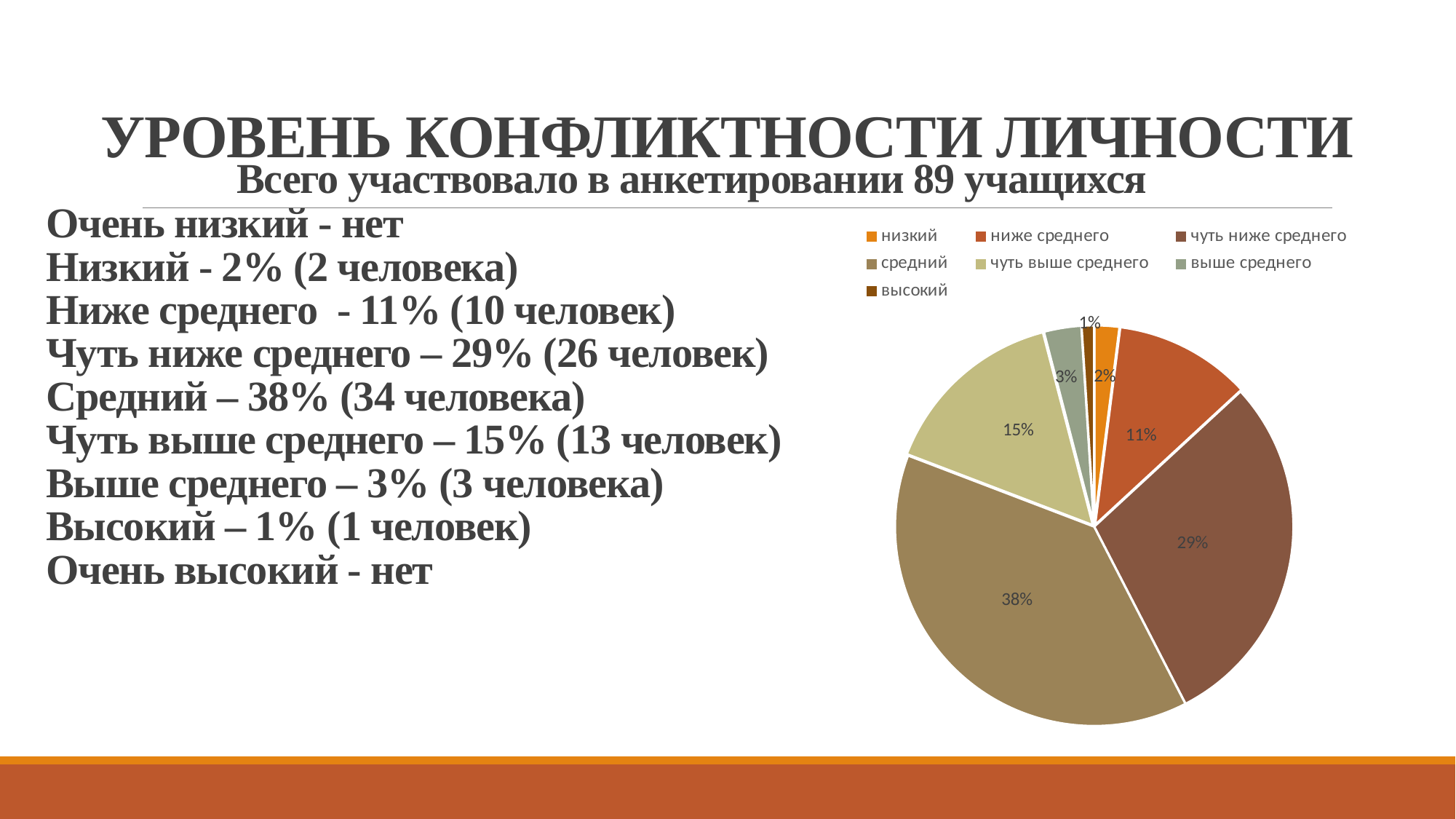
How many slices does the pie chart have? 7 Which category has the largest slice in the pie chart? средний What is the difference between the "средний" and "чуть ниже среднего" slices? 9% What kind of chart is shown on the slide? pie chart How many entries does the legend list? 7 What share of the pie does the "средний" slice take? 38% What is the value shown for "ниже среднего" in the pie chart? 11% Which slice is larger: "выше среднего" or "ниже среднего"? ниже среднего What colour is the "низкий" slice in the pie chart? orange What is the value shown for "чуть ниже среднего" in the pie chart? 29% Which category has the smallest slice in the pie chart? высокий What is the value shown for "чуть выше среднего" in the pie chart? 15%